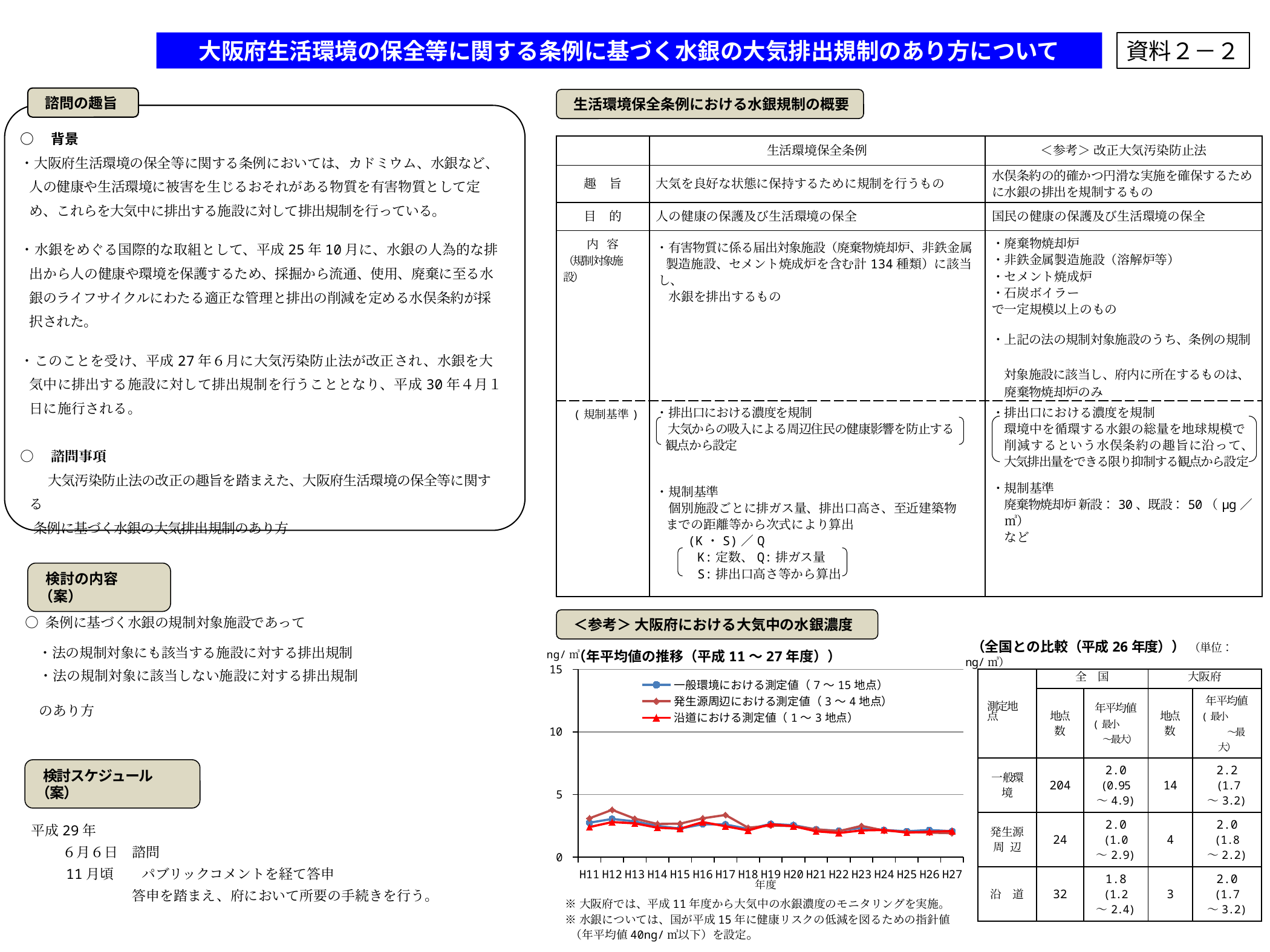
Is the value for 発生源周辺における測定値 in H12 greater or less than 5? less Is the value for 一般環境における測定値 in H27 greater or less than 5? less What is the first fiscal year shown on the x axis of the line chart? H11 What kind of chart is shown under the heading ＜参考＞大阪府における大気中の水銀濃度? line chart How many series does the legend of the line chart list? 3 Is the value for 沿道における測定値 in H11 greater or less than 10? less How many fiscal years are plotted along the x axis of the line chart? 17 What is the last fiscal year shown on the x axis of the line chart? H27 What is the unit shown on the y axis of the line chart? ng/㎥ In H12, which series has the highest value in the line chart? 発生源周辺における測定値 Do the values for 発生源周辺における測定値 generally rise or fall from H11 to H27? fall For 発生源周辺における測定値, which fiscal year has the highest value? H12